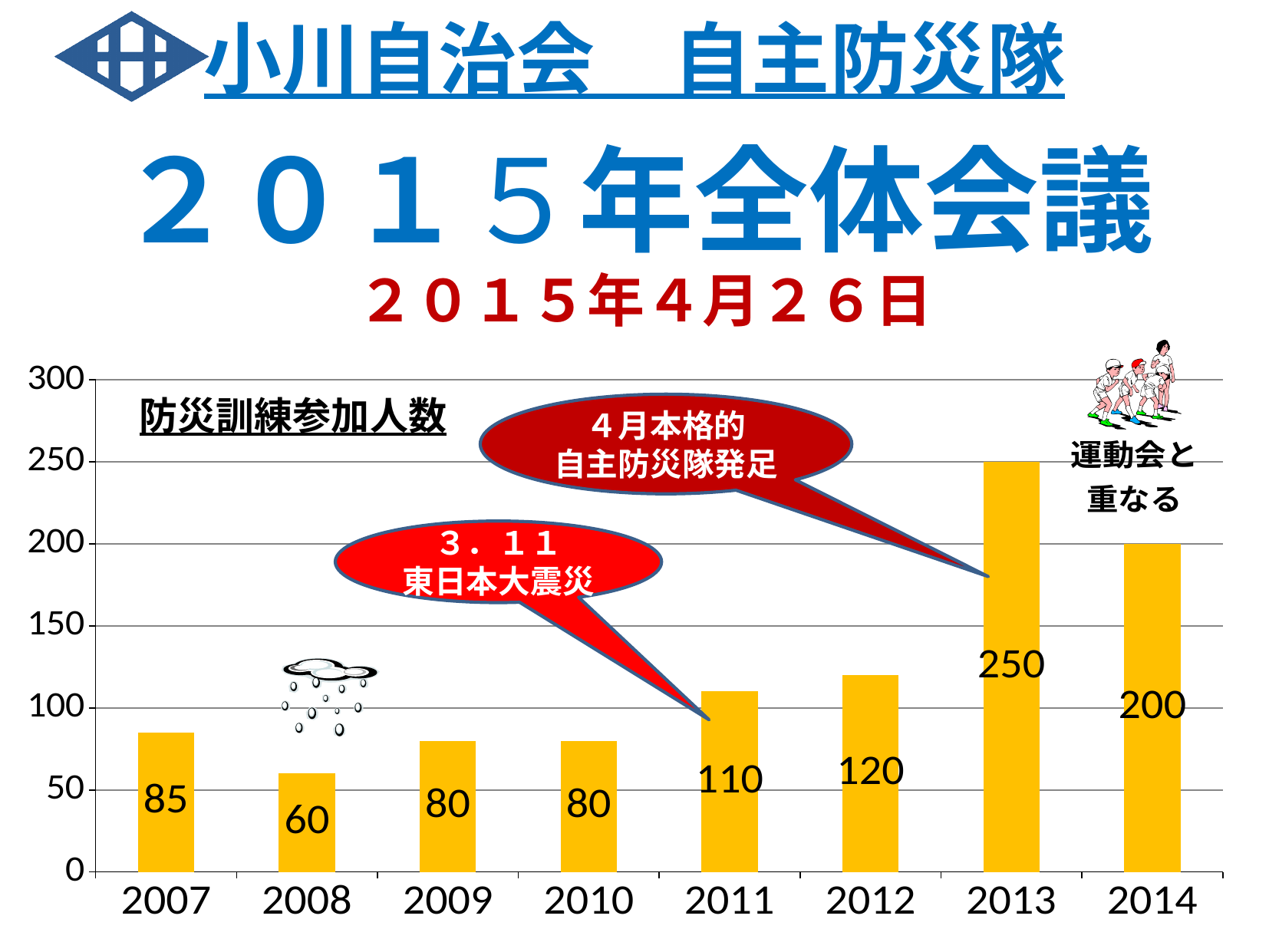
What kind of chart is shown on the slide? bar chart What is the value for 2011? 110 Which year has the lowest value? 2008 Which is larger, the value for 2007 or the value for 2009? 2007 Which year has the highest value? 2013 What is the difference between the values for 2013 and 2014? 50 How many years are shown on the x axis? 8 What is the title of the chart? 防災訓練参加人数 Is the value for 2013 greater or less than 200? greater What is the value for 2014? 200 What is the value for 2007? 85 What is the difference between the values for 2012 and 2008? 60